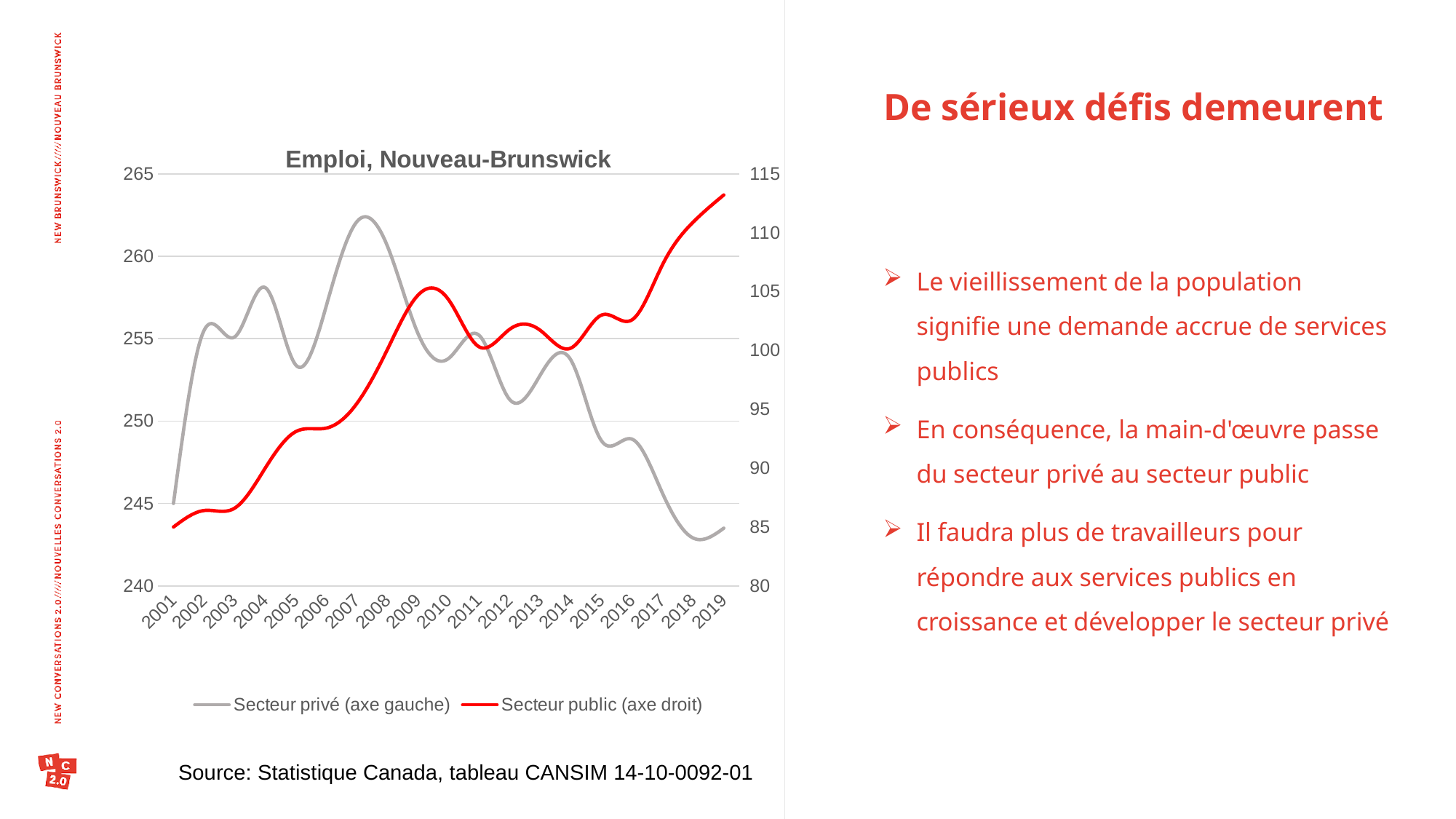
What is the title of the chart? Emploi, Nouveau-Brunswick Does the Secteur public series generally rise or fall from 2001 to 2019? rise How many series does the chart's legend list? 2 In which year does the Secteur privé series reach its highest value? 2007 In which year does the Secteur public series have its lowest value? 2001 How many years are plotted along the x axis of the chart? 19 Which series is plotted against the right axis? Secteur public (axe droit) Is the value for Secteur public in 2019 greater or less than 110? greater In which year does the Secteur public series reach its highest value? 2019 Is the value for Secteur public in 2001 greater or less than 90? less Is the value for Secteur privé in 2007 greater or less than 260? greater What kind of chart is shown on the slide? line chart